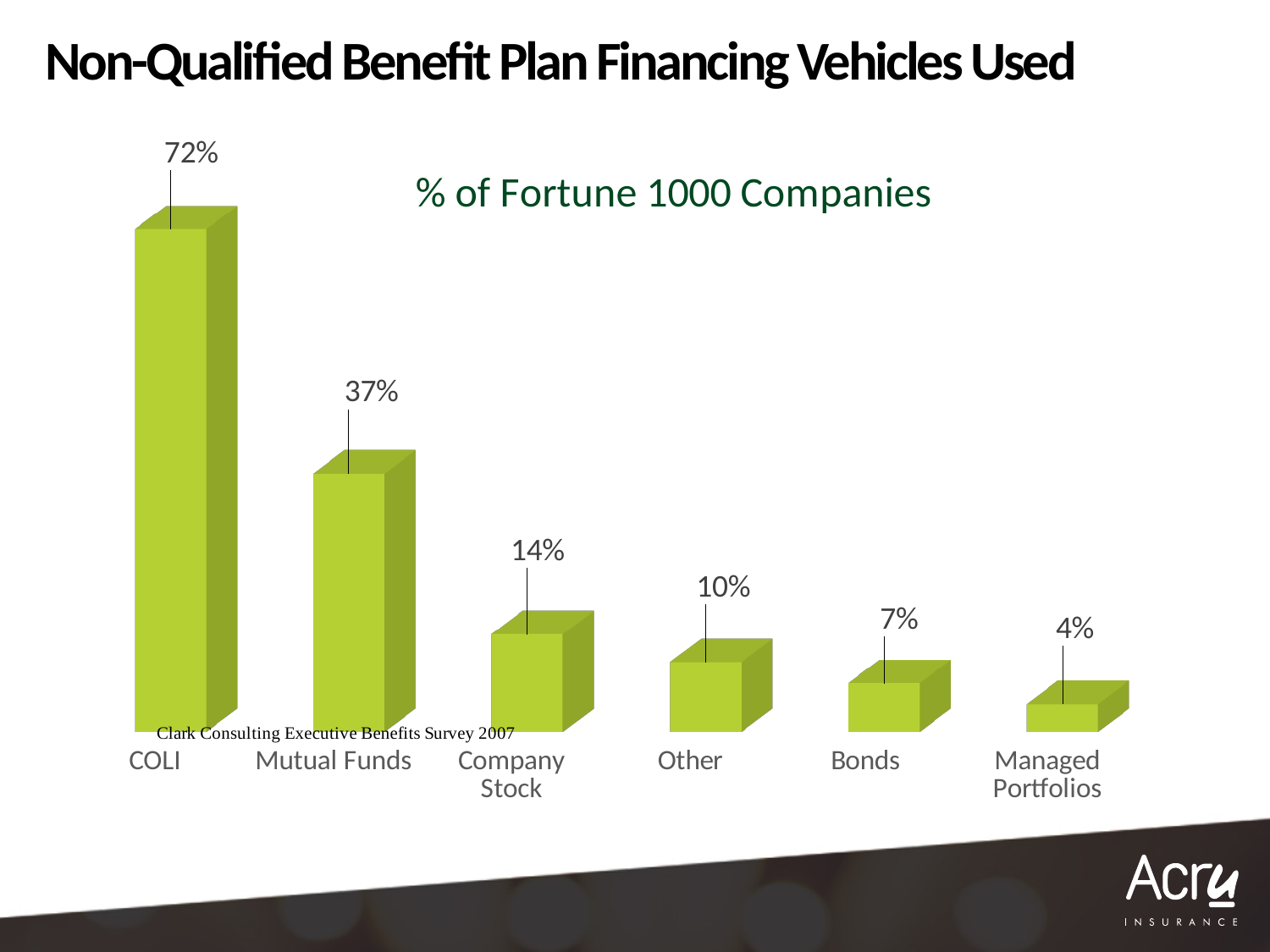
What is the value shown for Mutual Funds? 37% What type of chart is shown on the slide? Bar chart How many financing vehicle categories are shown in the chart? 6 What is the value shown for Company Stock? 14% Which financing vehicle has the lowest percentage? Managed Portfolios What is the difference in percentage points between Other and Bonds? 3 What is the difference in percentage points between COLI and Mutual Funds? 35 What percentage of Fortune 1000 companies use COLI as a financing vehicle? 72% Which financing vehicle has the highest percentage? COLI What is the value shown for Bonds? 7% Which is larger, the value for Company Stock or the value for Other? Company Stock What is the source cited for the chart data? Clark Consulting Executive Benefits Survey 2007